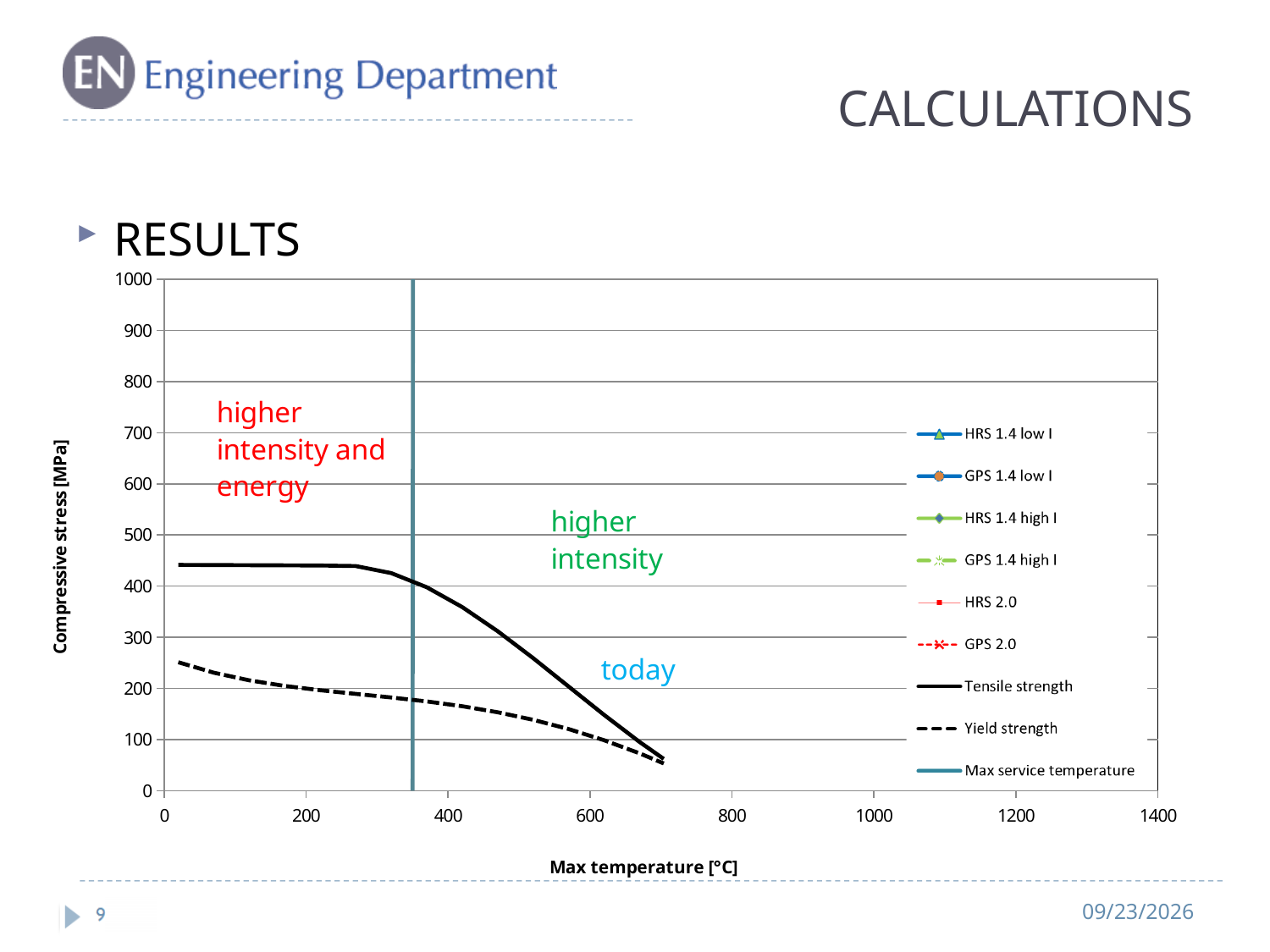
What is the highest value shown on the vertical axis of the chart? 1000 What is the title of the horizontal axis of the chart? Max temperature [°C] Is the Yield strength value at 400 °C greater or less than 200? less Does the Tensile strength curve rise or fall as Max temperature increases? fall Is the Tensile strength value at 700 °C greater or less than 100? less Is the Max service temperature line positioned at a temperature greater or less than 400 °C? less What is the title of the vertical axis of the chart? Compressive stress [MPa] At 400 °C, which is larger: Tensile strength or Yield strength? Tensile strength How many series does the chart legend list? 9 What kind of chart is shown on the slide? line chart Does the Yield strength curve rise or fall as Max temperature increases? fall